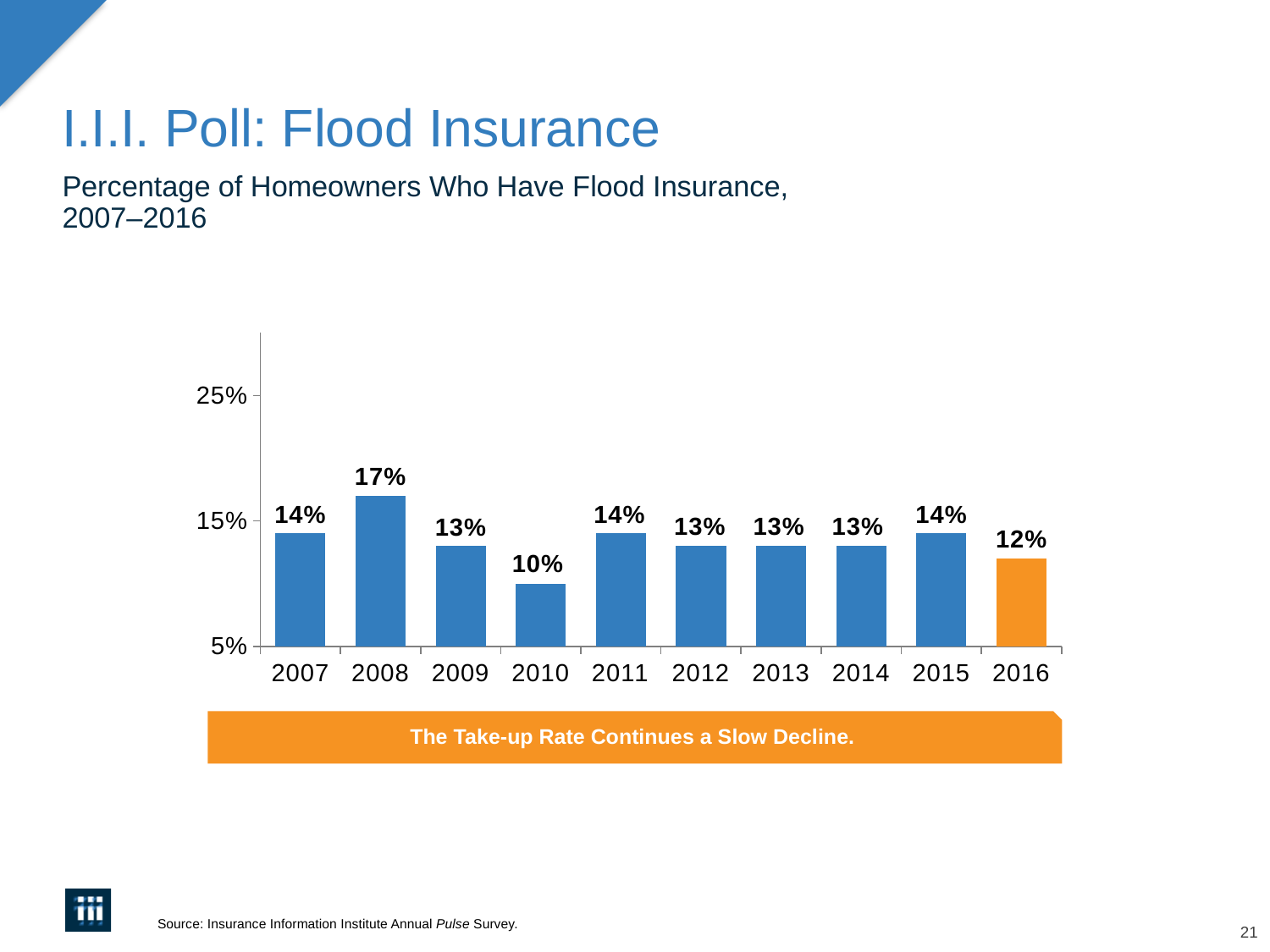
What kind of chart is shown on the slide? Bar chart Which year has the highest percentage of homeowners with flood insurance? 2008 What is the difference between the 2008 value and the 2016 value? 5% Which year has the lowest percentage of homeowners with flood insurance? 2010 What is the value shown for 2010? 10% Is the value for 2008 greater or less than 15%? greater Which year has a higher value, 2015 or 2016? 2015 How many years are shown on the x axis? 10 What is the difference between the 2007 value and the 2010 value? 4% Which bar is shown in a different colour (orange) from the others? 2016 What percentage of homeowners had flood insurance in 2016? 12% What percentage of homeowners had flood insurance in 2008? 17%